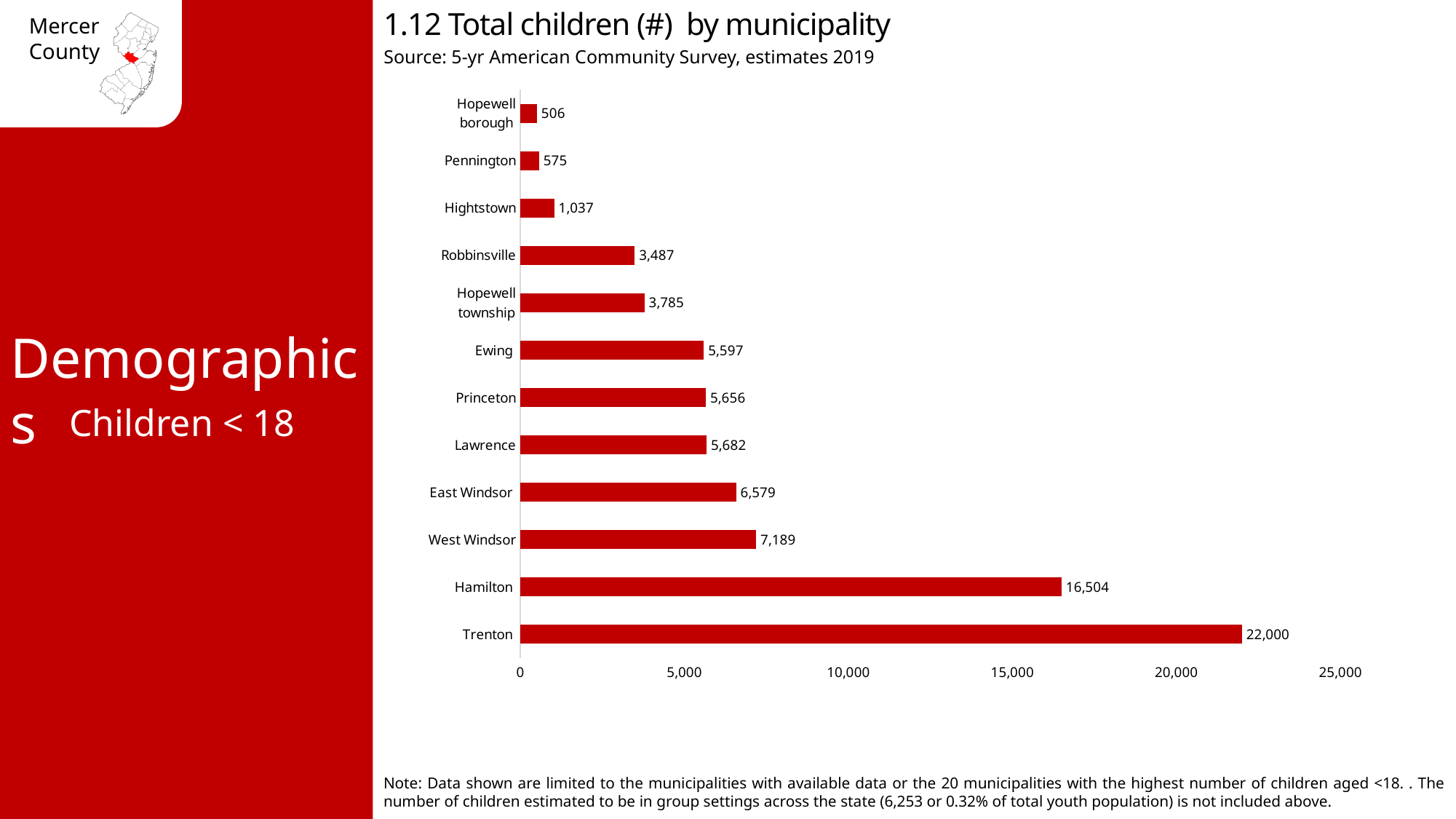
What is the source of the data shown in the chart? 5-yr American Community Survey, estimates 2019 Which has more children, Robbinsville or Hightstown? Robbinsville Which municipality has the lowest total number of children? Hopewell borough What is the difference in total children between Trenton and Hamilton? 5,496 What is the total number of children in West Windsor? 7,189 What is the total number of children in Hopewell township? 3,785 What kind of chart is used to show total children by municipality? bar chart Which municipality has the highest total number of children? Trenton How many municipalities are shown in the chart? 12 Is the value for Hamilton greater or less than 15,000? greater What is the total number of children in Trenton? 22,000 What is the difference in total children between East Windsor and Ewing? 982